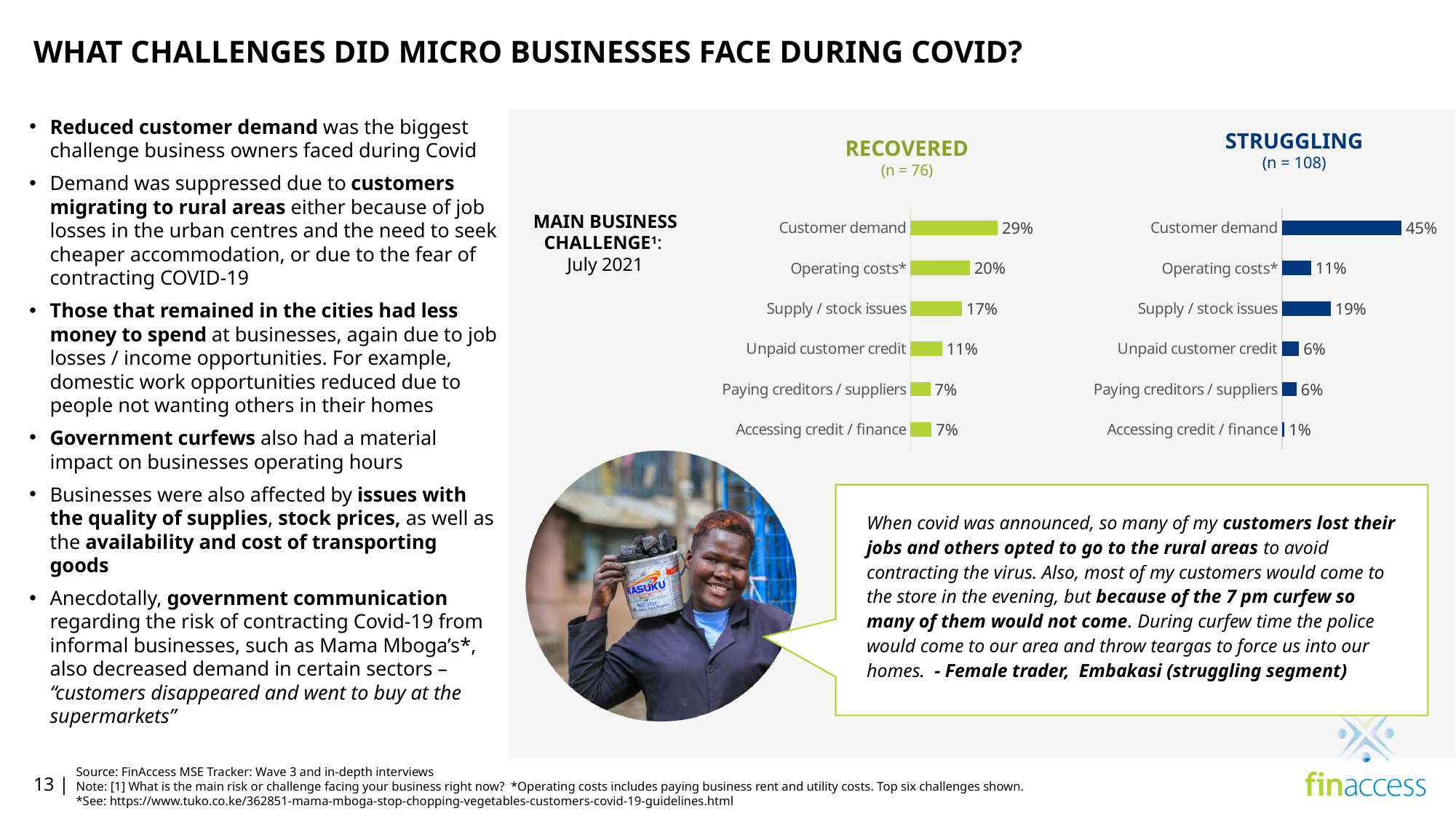
In the STRUGGLING chart, which category has the highest value? Customer demand In the RECOVERED chart, what is the value for Operating costs*? 20% What is the difference between the Customer demand values in the STRUGGLING chart and the RECOVERED chart? 16 percentage points In the STRUGGLING chart, which category has the lowest value? Accessing credit / finance Which is larger: Operating costs* in the RECOVERED chart or Operating costs* in the STRUGGLING chart? RECOVERED In the RECOVERED chart, what is the value for Customer demand? 29% What kind of chart is the STRUGGLING chart? Bar chart In the RECOVERED chart, which category has the highest value? Customer demand In the STRUGGLING chart, what is the value for Accessing credit / finance? 1% What is the sample size (n) shown for the STRUGGLING chart? 108 In the STRUGGLING chart, what is the value for Customer demand? 45% How many categories are shown in the RECOVERED chart? 6